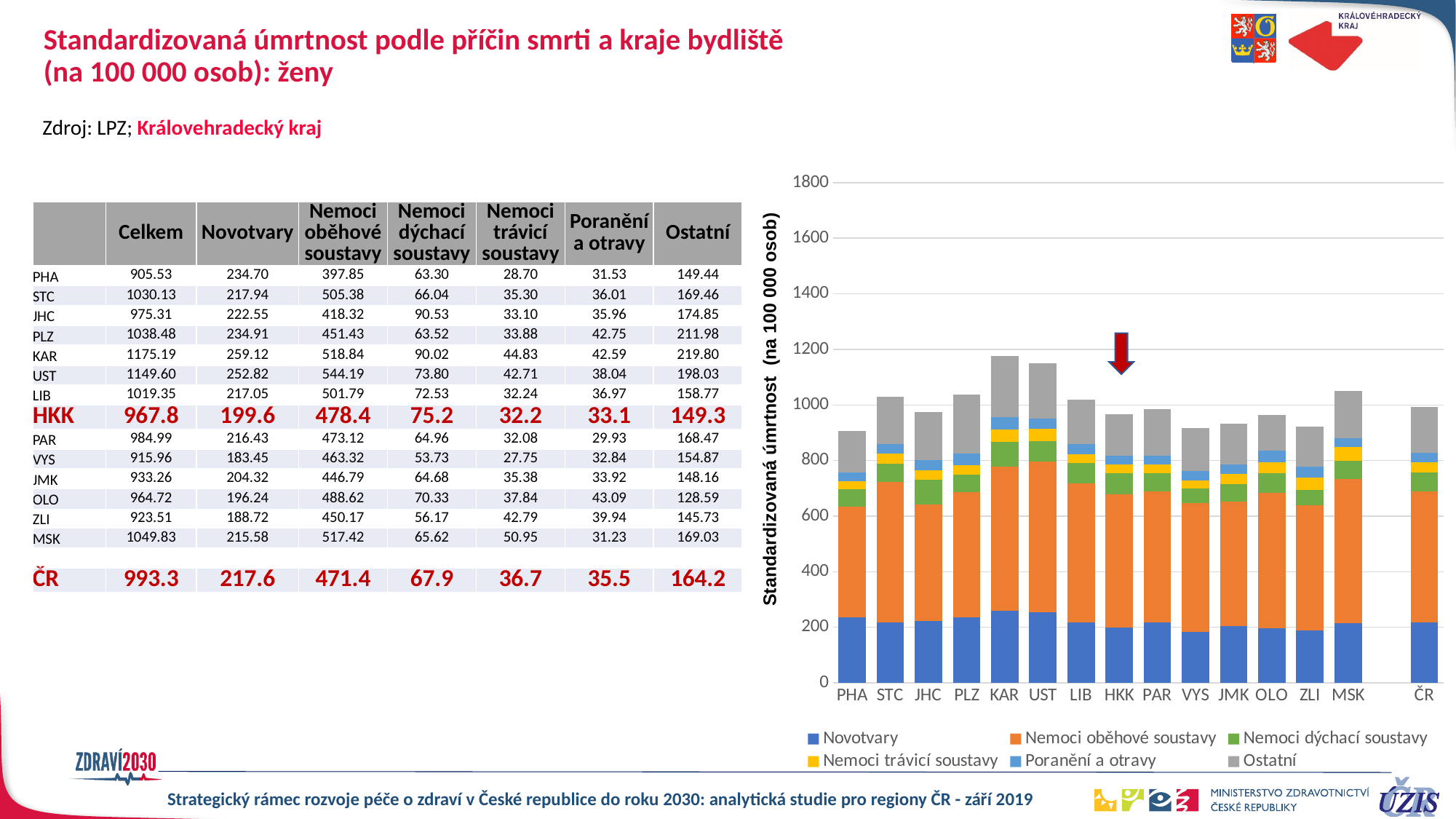
What is the difference between the total for KAR and the total for HKK? 207.39 What is the value of Novotvary for ČR? 217.6 Which region has the lowest total standardized mortality in the chart? PHA What is the total height of the stacked bar for HKK (Celkem)? 967.8 How many regions (categories) are shown on the x axis of the chart? 15 Is the total bar for KAR greater or less than 1000? greater Which region has the highest total standardized mortality in the chart? KAR Is the total bar for HKK greater or less than 1000? less Which is larger, the total for UST or the total for STC? UST How many series does the chart legend list? 6 What is the value of Nemoci oběhové soustavy for HKK? 478.4 What kind of chart is shown on the slide? Stacked bar chart